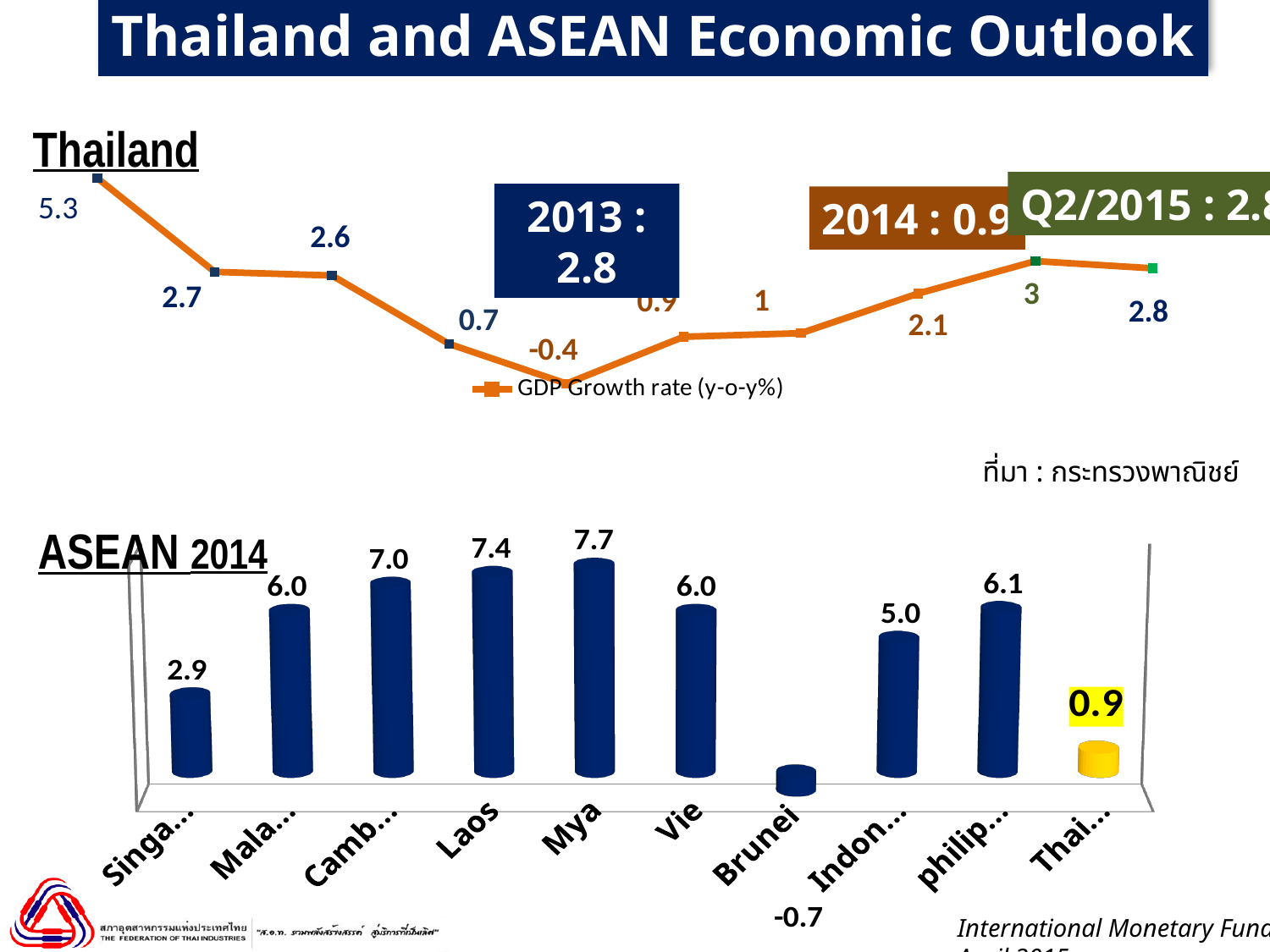
On the ASEAN 2014 chart, which country has the lowest value? Brunei What kind of chart is the Thailand chart at the top of the slide? line chart On the ASEAN 2014 chart, which country has the highest value? Mya On the ASEAN 2014 chart, what is the value for Brunei? -0.7 On the ASEAN 2014 chart, what is the value for Vie? 6.0 On the ASEAN 2014 chart, what is the value for Mya? 7.7 On the ASEAN 2014 chart, what is the difference between the values for Mya and Laos? 0.3 What kind of chart is the ASEAN 2014 chart? bar chart On the ASEAN 2014 chart, which is larger, the value for Vie or the value for Laos? Laos On the ASEAN 2014 chart, how many bars are plotted? 10 On the ASEAN 2014 chart, what is the value for Laos? 7.4 On the Thailand chart, what is the lowest data label shown on the line? -0.4